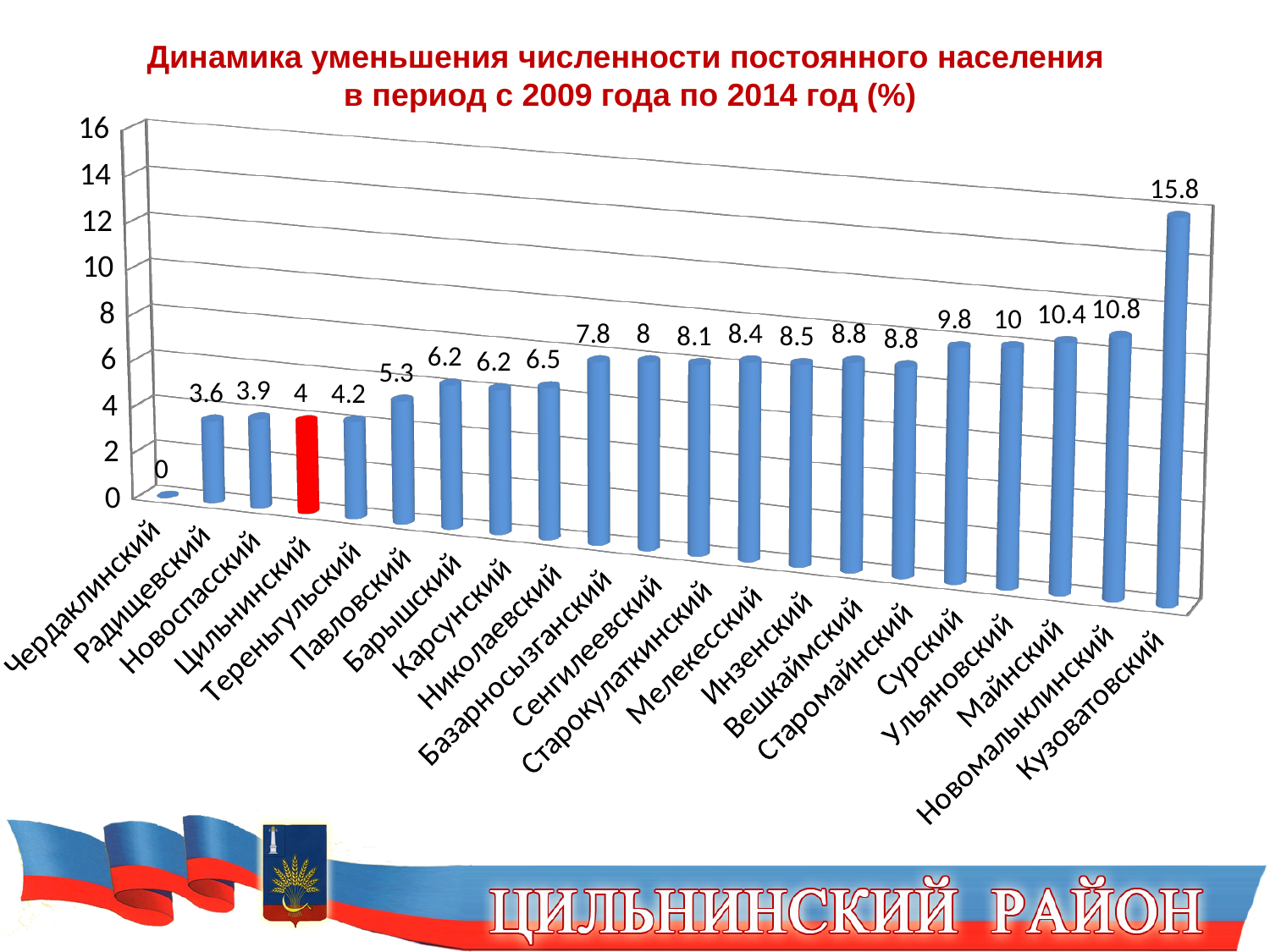
How many categories are shown on the x axis? 21 What kind of chart is shown on the slide? Bar chart What is the value for Цильнинский? 4 What is the difference between the values for Кузоватовский and Новомалыклинский? 5 Which category has the highest value? Кузоватовский Which category's bar is coloured red instead of blue? Цильнинский Which is larger, the value for Сурский or the value for Мелекесский? Сурский What is the value for Павловский? 5.3 Which category has the lowest value? Чердаклинский Do the values generally rise or fall from left to right along the x axis? Rise What is the value for Новомалыклинский? 10.8 What is the value for Кузоватовский? 15.8